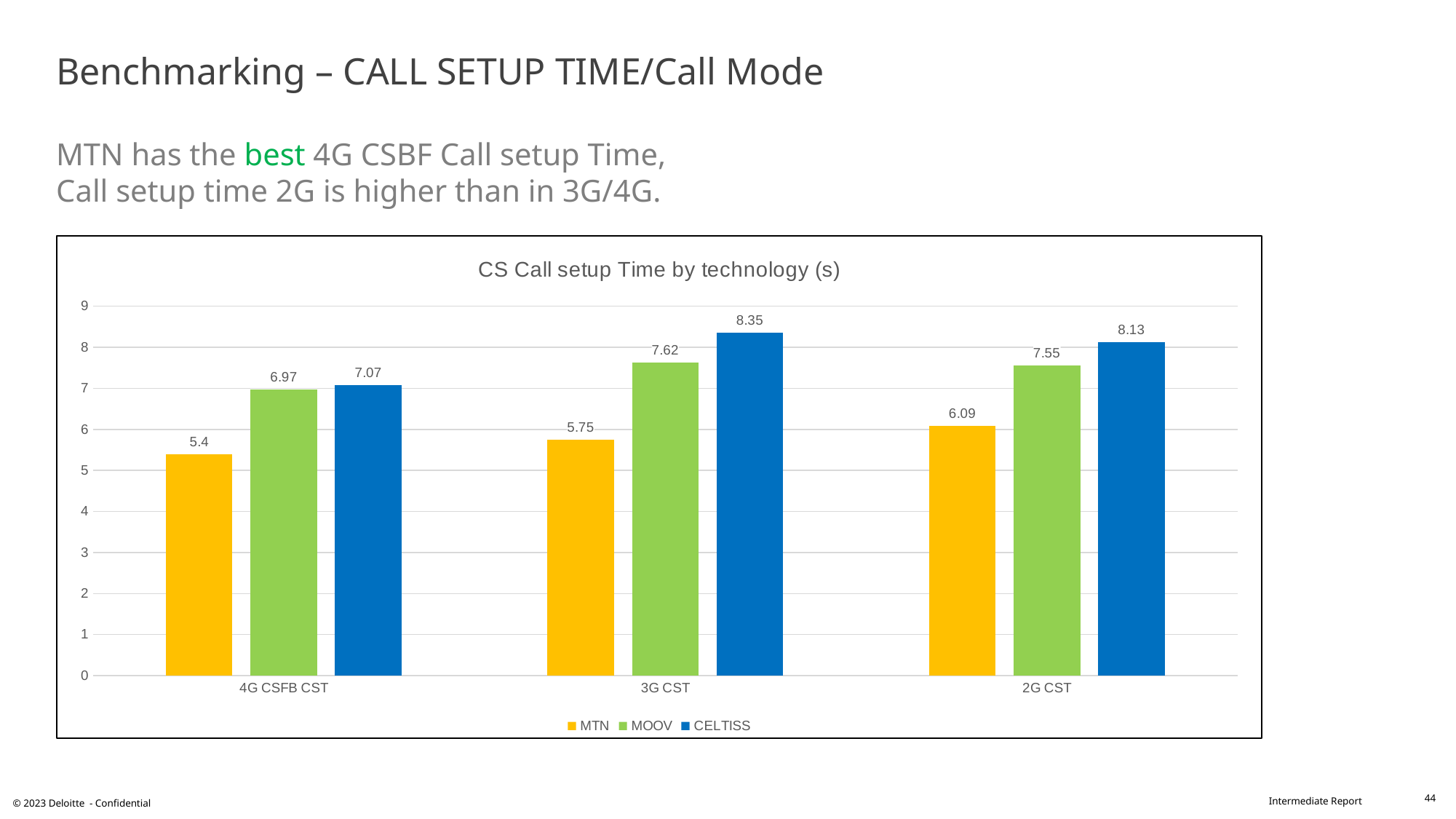
How many technology categories are shown on the x axis? 3 What is the difference between the CELTISS and MTN call setup times in the 4G CSFB CST category? 1.67 Which operator has the lowest call setup time in the 3G CST category? MTN Is the value for MTN in the 2G CST category greater or less than 7? less What kind of chart is shown on the slide? Bar chart Which is larger: MOOV's call setup time for 3G CST or for 2G CST? 3G CST What is the CS call setup time for MOOV in the 2G CST category? 7.55 What is the title of the chart? CS Call setup Time by technology (s) Which operator has the highest call setup time in the 2G CST category? CELTISS How many series does the legend list? 3 What is the CS call setup time for CELTISS in the 3G CST category? 8.35 What is the CS call setup time for MTN in the 4G CSFB CST category? 5.4